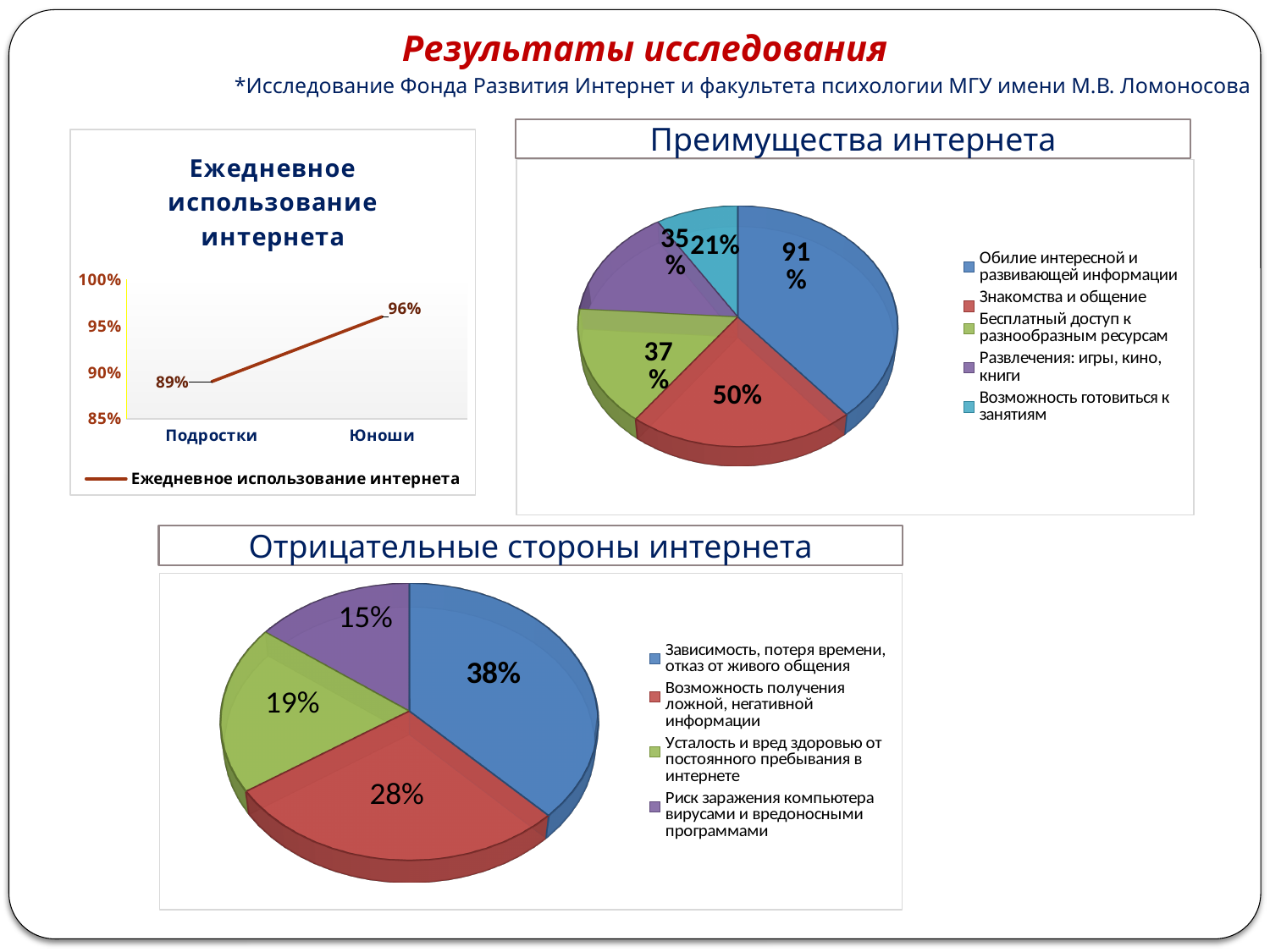
In the chart 'Преимущества интернета', which category has the highest value? Обилие интересной и развивающей информации In the chart 'Ежедневное использование интернета', do the values rise or fall from Подростки to Юноши? rise In the chart 'Отрицательные стороны интернета', what is the value for 'Возможность получения ложной, негативной информации'? 28% In the chart 'Ежедневное использование интернета', what is the value for Подростки? 89% In the chart 'Ежедневное использование интернета', what is the difference between the values for Юноши and Подростки? 7% What kind of chart is 'Ежедневное использование интернета'? line chart In the chart 'Отрицательные стороны интернета', which category has the lowest value? Риск заражения компьютера вирусами и вредоносными программами How many categories does the legend of the chart 'Преимущества интернета' list? 5 In the chart 'Отрицательные стороны интернета', what is the difference between the values for 'Зависимость, потеря времени, отказ от живого общения' and 'Усталость и вред здоровью от постоянного пребывания в интернете'? 19% In the chart 'Преимущества интернета', what is the value for 'Возможность готовиться к занятиям'? 21% In the chart 'Преимущества интернета', what is the value for 'Знакомства и общение'? 50% In the chart 'Ежедневное использование интернета', what is the value for Юноши? 96%